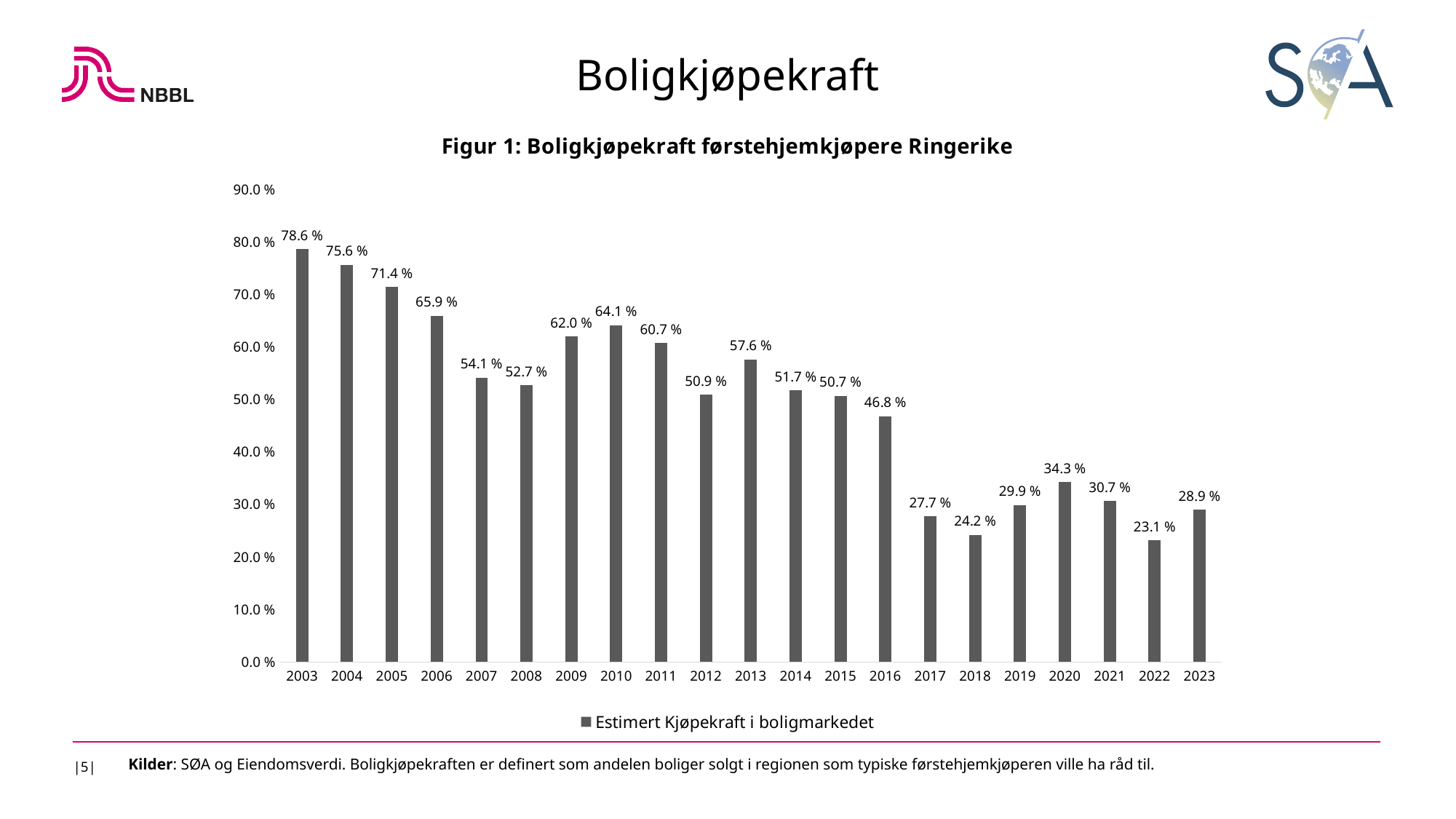
Which year has the lowest value? 2022 How many series does the legend list? 1 What is the title of the chart? Figur 1: Boligkjøpekraft førstehjemkjøpere Ringerike Which year has the highest value? 2003 What is the difference between the values for 2003 and 2023? 49.7 % What is the value for 2013? 57.6 % Is the value for 2016 greater or less than 50.0 %? less What is the value for 2022? 23.1 % Which is larger, the value for 2010 or the value for 2011? 2010 What kind of chart is shown? bar chart What is the value for 2003? 78.6 % How many years are shown on the x axis? 21